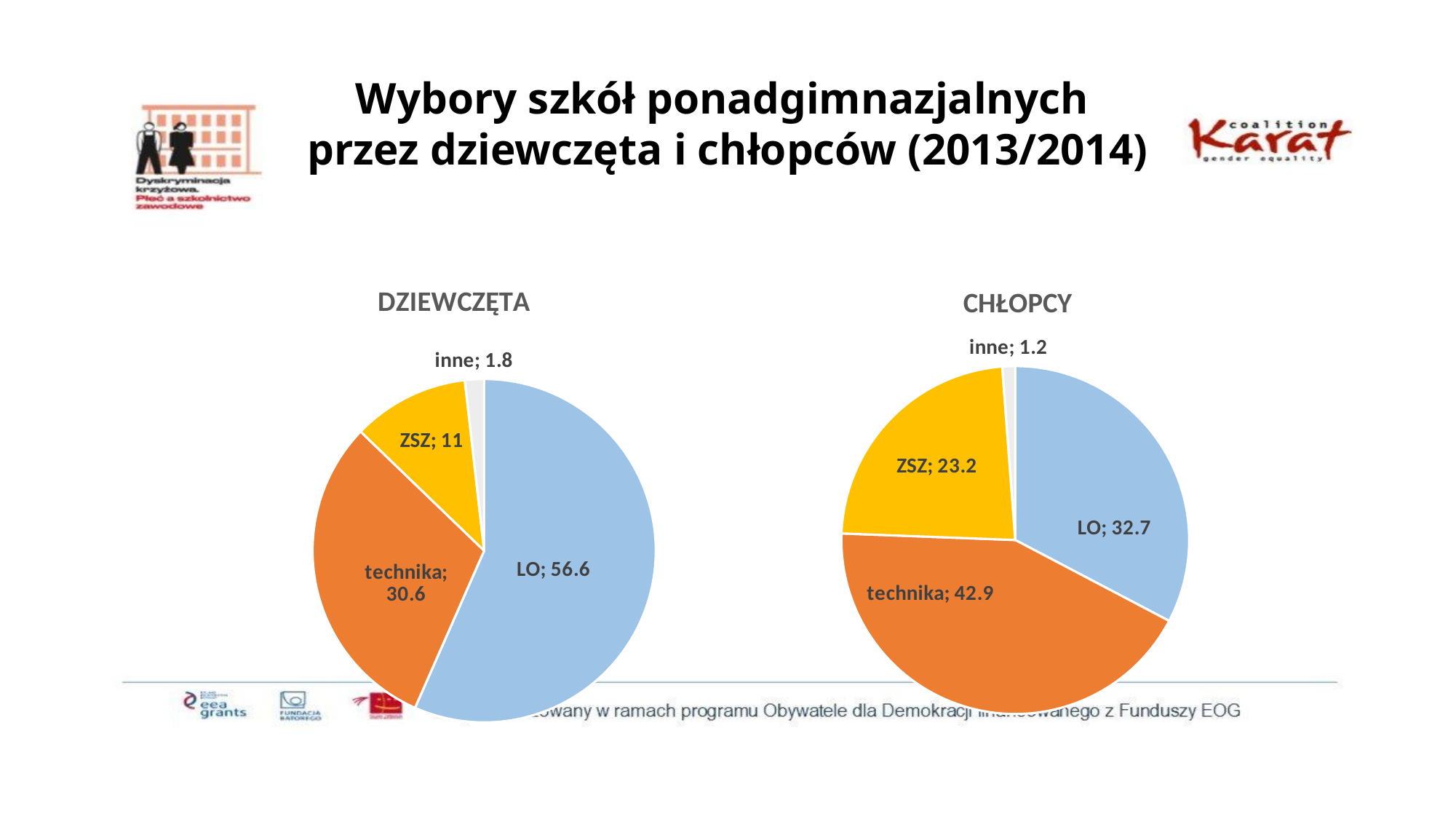
In the CHŁOPCY chart, what is the value for inne? 1.2 How many slices does the DZIEWCZĘTA chart have? 4 In the CHŁOPCY chart, what is the difference between technika and ZSZ? 19.7 In the CHŁOPCY chart, which category has the largest slice? technika In the CHŁOPCY chart, what is the value for technika? 42.9 In the CHŁOPCY chart, which category has the smallest slice? inne Which is larger: ZSZ in the DZIEWCZĘTA chart or ZSZ in the CHŁOPCY chart? ZSZ in the CHŁOPCY chart In the DZIEWCZĘTA chart, what is the value for LO? 56.6 What is the difference between the LO value in the DZIEWCZĘTA chart and the LO value in the CHŁOPCY chart? 23.9 In the DZIEWCZĘTA chart, which category has the largest slice? LO In the DZIEWCZĘTA chart, what is the value for ZSZ? 11 What type of chart is used for CHŁOPCY? Pie chart